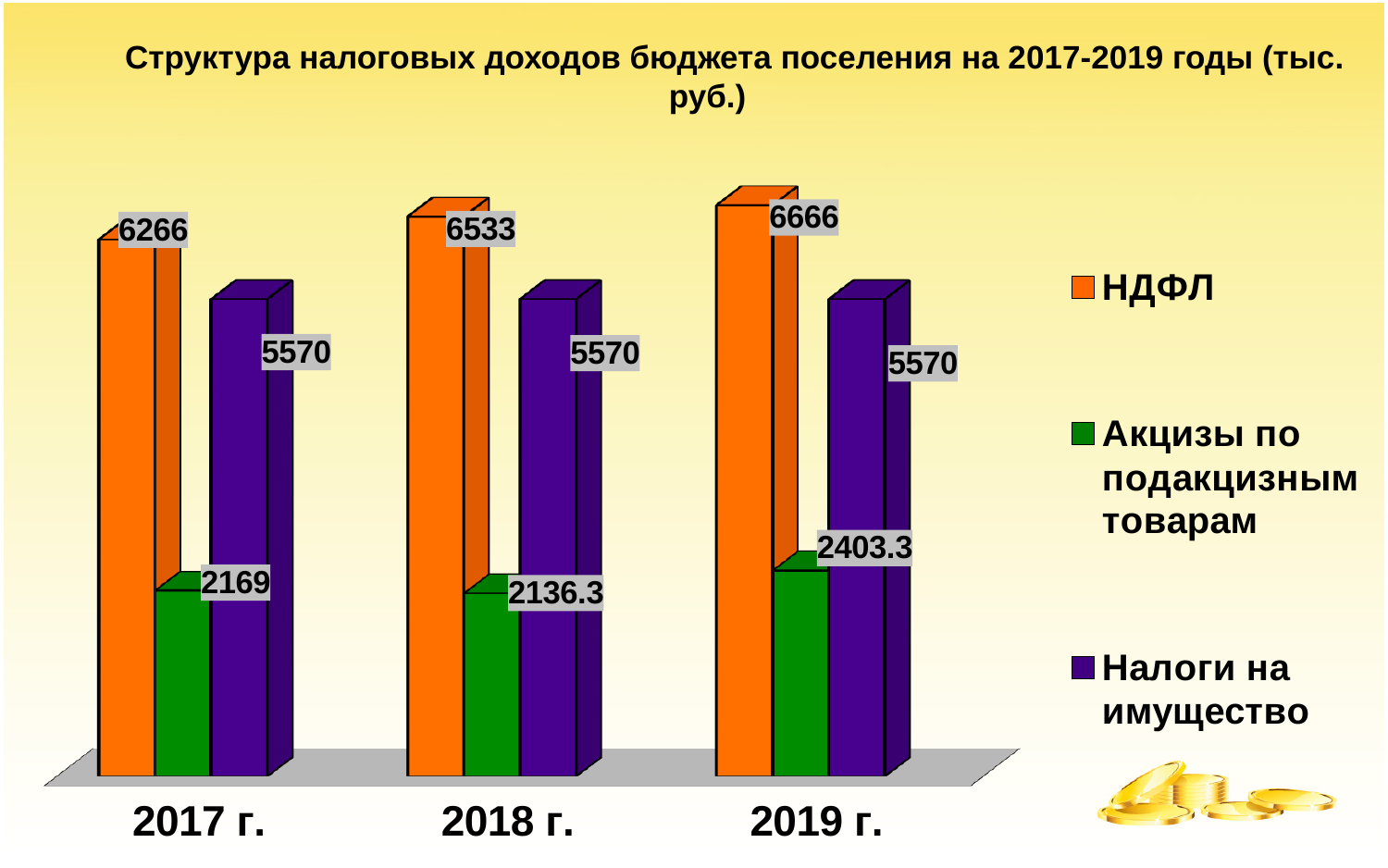
What is the value for Акцизы по подакцизным товарам in 2018 г.? 2136.3 How many series does the legend list? 3 How many years are shown on the x axis? 3 Which is larger in 2018 г.: НДФЛ or Налоги на имущество? НДФЛ What is the value for НДФЛ in 2017 г.? 6266 What kind of chart is this? bar chart Does the НДФЛ value rise or fall from 2017 г. to 2019 г.? rise In which year is the Акцизы по подакцизным товарам value lowest? 2018 г. What is the value for Акцизы по подакцизным товарам in 2019 г.? 2403.3 What is the value for Налоги на имущество in 2019 г.? 5570 What is the difference between the НДФЛ values for 2019 г. and 2017 г.? 400 In which year is the НДФЛ value highest? 2019 г.